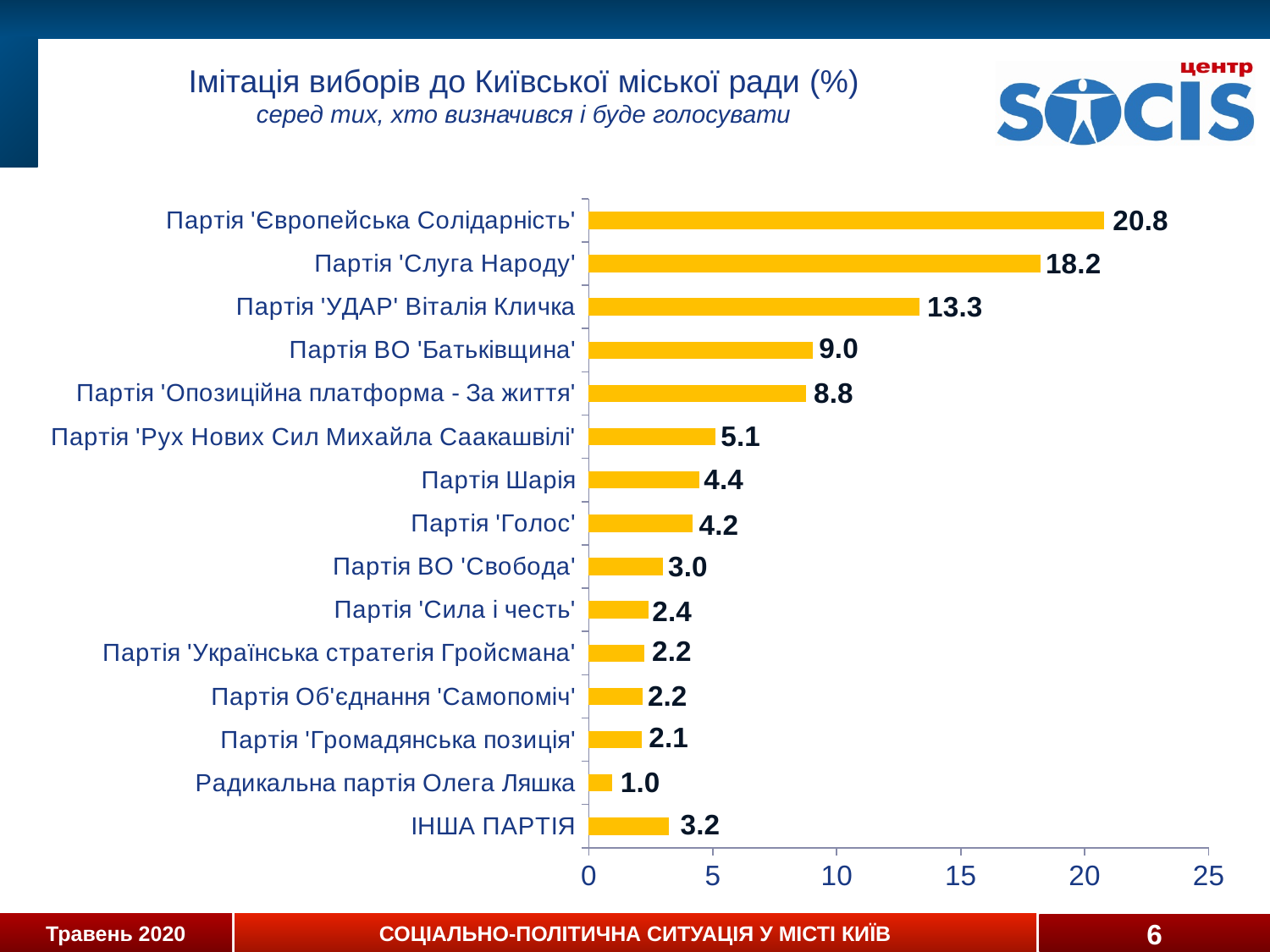
What value is shown for Партія 'Опозиційна платформа - За життя'? 8.8 Which category has the lowest value on the chart? Радикальна партія Олега Ляшка What is the difference between the values for Партія 'Європейська Солідарність' and Партія 'Слуга Народу'? 2.6 What value is shown for Радикальна партія Олега Ляшка? 1.0 What kind of chart is shown on the slide? bar chart What is the value shown for ІНША ПАРТІЯ? 3.2 How many categories are shown on the chart? 15 Is the value for Партія 'Слуга Народу' greater or less than 15? greater Which is larger, the value for Партія ВО 'Батьківщина' or Партія 'Опозиційна платформа - За життя'? Партія ВО 'Батьківщина' Which party has the highest value on the chart? Партія 'Європейська Солідарність' What value is shown for Партія 'УДАР' Віталія Кличка? 13.3 What value is shown for Партія 'Європейська Солідарність'? 20.8